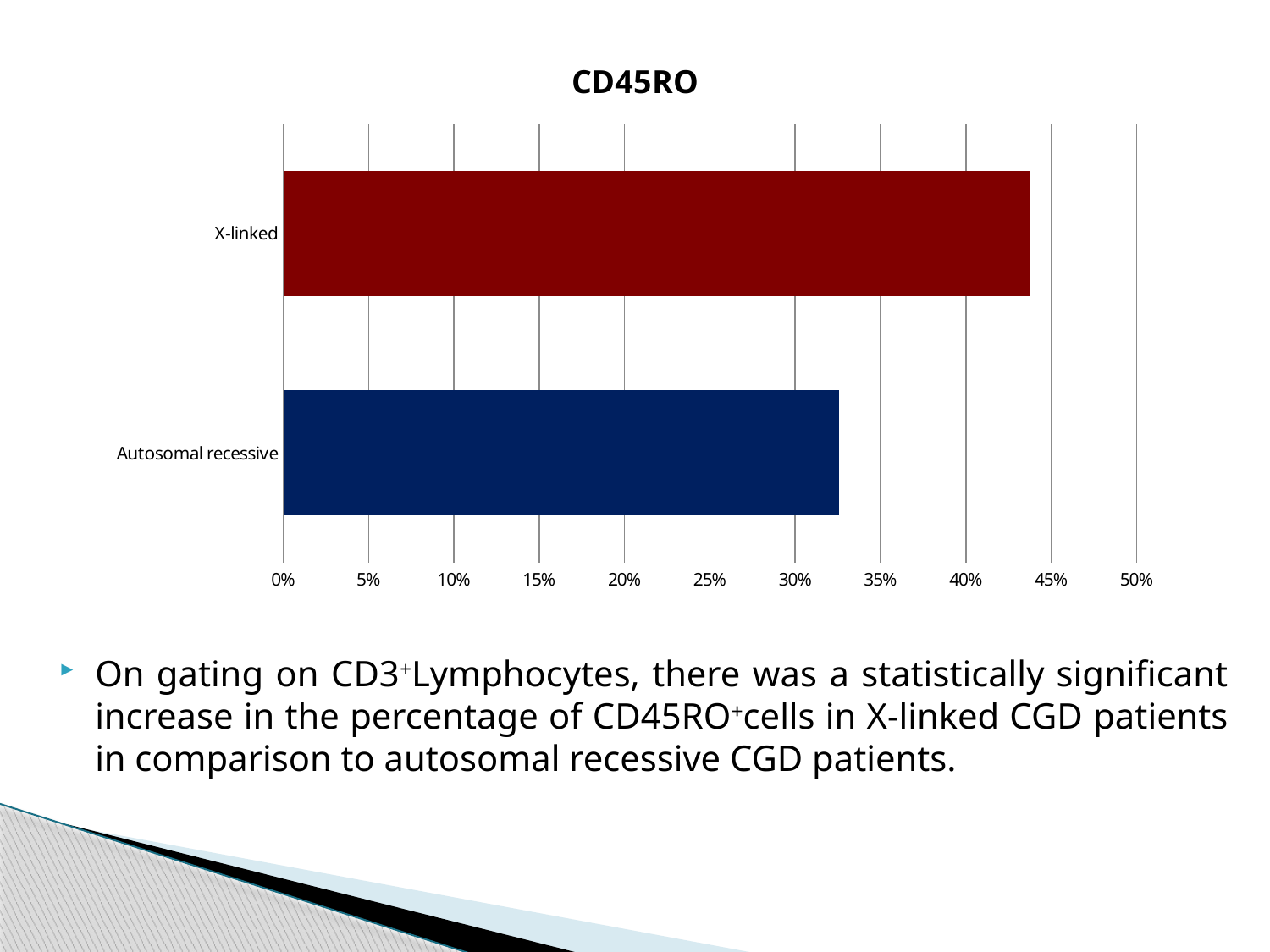
Which category has the lowest value? Autosomal recessive What is the title of the chart? CD45RO Which category has the highest value? X-linked Is the value for Autosomal recessive greater or less than 30%? greater Is the value for X-linked greater or less than 45%? less What kind of chart is shown on the slide? bar chart Which is larger, the value for X-linked or the value for Autosomal recessive? X-linked What is the highest value shown on the horizontal axis? 50% Is the value for Autosomal recessive greater or less than 35%? less How many categories are plotted in the chart? 2